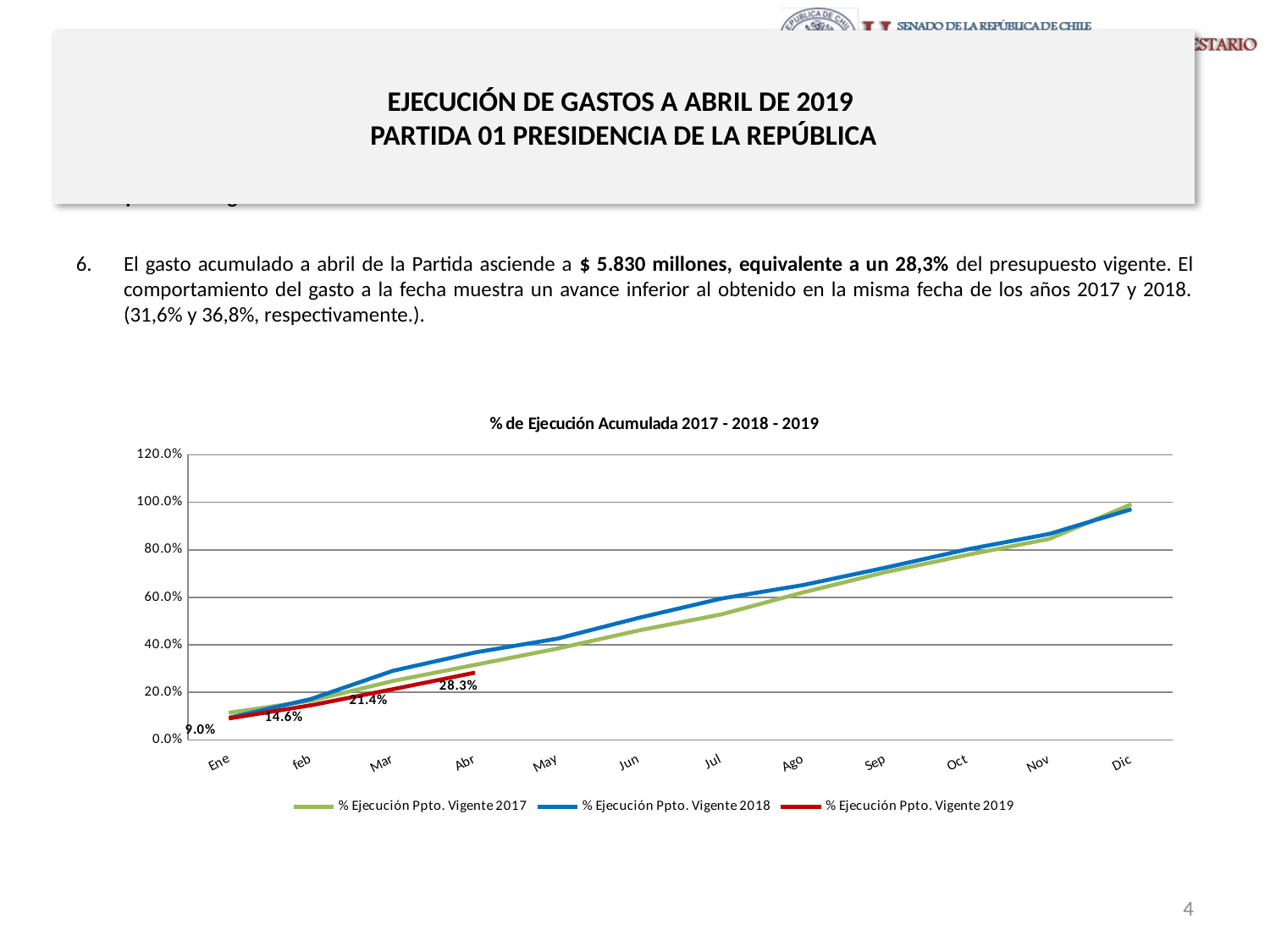
What kind of chart is shown on the slide? line chart In which month does the % Ejecución Ppto. Vigente 2019 series reach its highest value? Abr What is the value of % Ejecución Ppto. Vigente 2019 in Ene? 9.0% What is the difference between the 2019 values for Feb and Ene? 5.6% What is the difference between the 2019 values for Abr and Mar? 6.9% What is the value of % Ejecución Ppto. Vigente 2019 in Abr? 28.3% Is the value for % Ejecución Ppto. Vigente 2018 in Dic greater or less than 80%? greater What is the title of the chart? % de Ejecución Acumulada 2017 - 2018 - 2019 Do the values of the % Ejecución Ppto. Vigente 2018 series rise or fall from Ene to Dic? rise What is the value of % Ejecución Ppto. Vigente 2019 in Mar? 21.4% How many months are shown along the x axis of the chart? 12 How many series does the legend of the chart list? 3